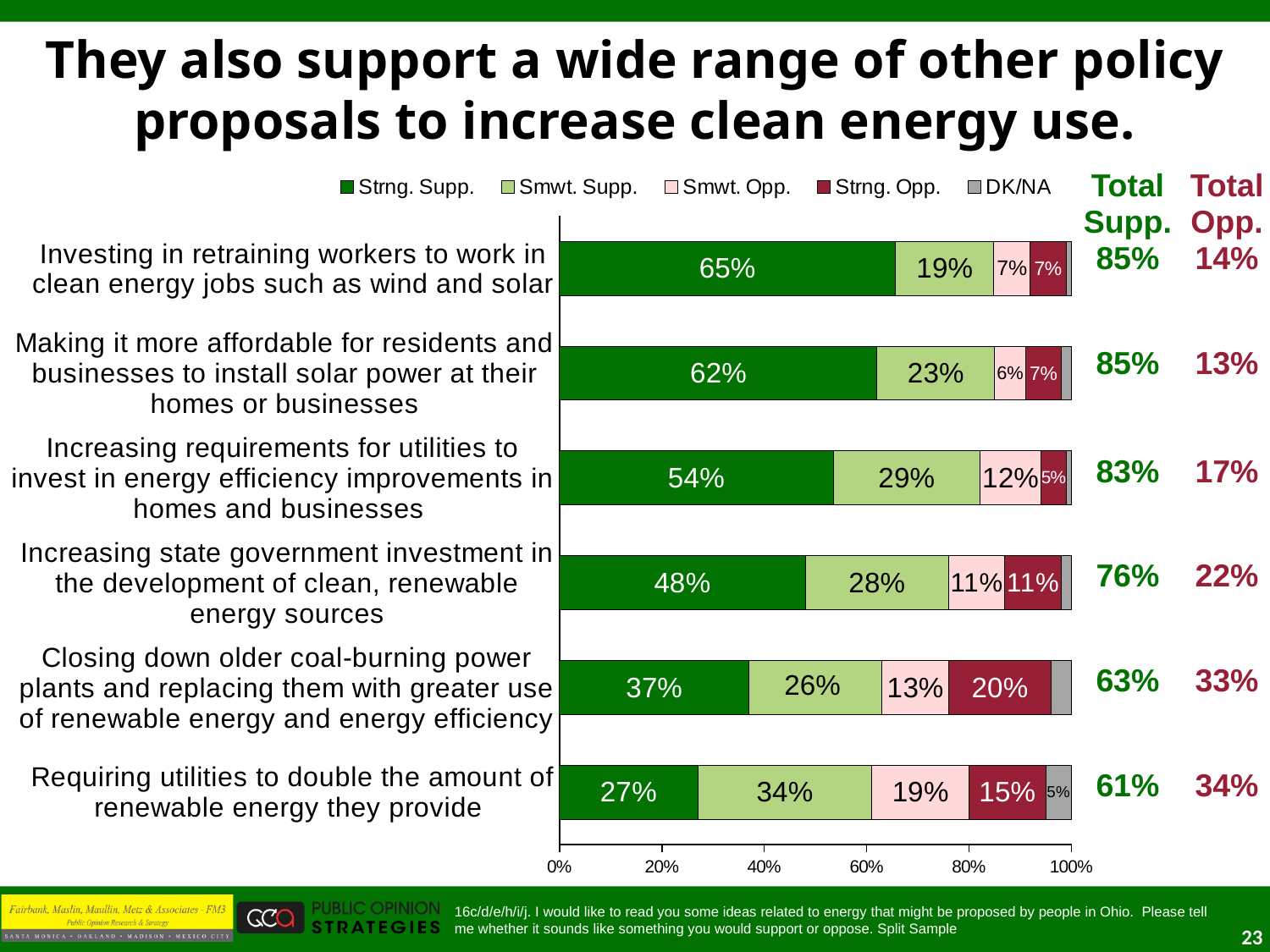
What is the Strng. Supp. value for "Investing in retraining workers to work in clean energy jobs such as wind and solar"? 65% Which is larger: the Smwt. Opp. value for "Closing down older coal-burning power plants" or the Smwt. Opp. value for "Increasing requirements for utilities to invest in energy efficiency improvements"? Closing down older coal-burning power plants Which legend entry is shown in dark green? Strng. Supp. What is the Smwt. Supp. value for "Requiring utilities to double the amount of renewable energy they provide"? 34% Which proposal has the highest Strng. Supp. value? Investing in retraining workers to work in clean energy jobs such as wind and solar How many series does the legend list? 5 What is the Total Supp. figure shown for "Increasing requirements for utilities to invest in energy efficiency improvements in homes and businesses"? 83% What kind of chart is shown on the slide? Stacked horizontal bar chart What is the Strng. Opp. value for "Closing down older coal-burning power plants and replacing them with greater use of renewable energy and energy efficiency"? 20% Which proposal has the lowest Strng. Supp. value? Requiring utilities to double the amount of renewable energy they provide How many policy proposals (categories) are plotted in the chart? 6 What is the difference between the Strng. Supp. values for "Making it more affordable for residents and businesses to install solar power" and "Increasing state government investment in the development of clean, renewable energy sources"? 14%